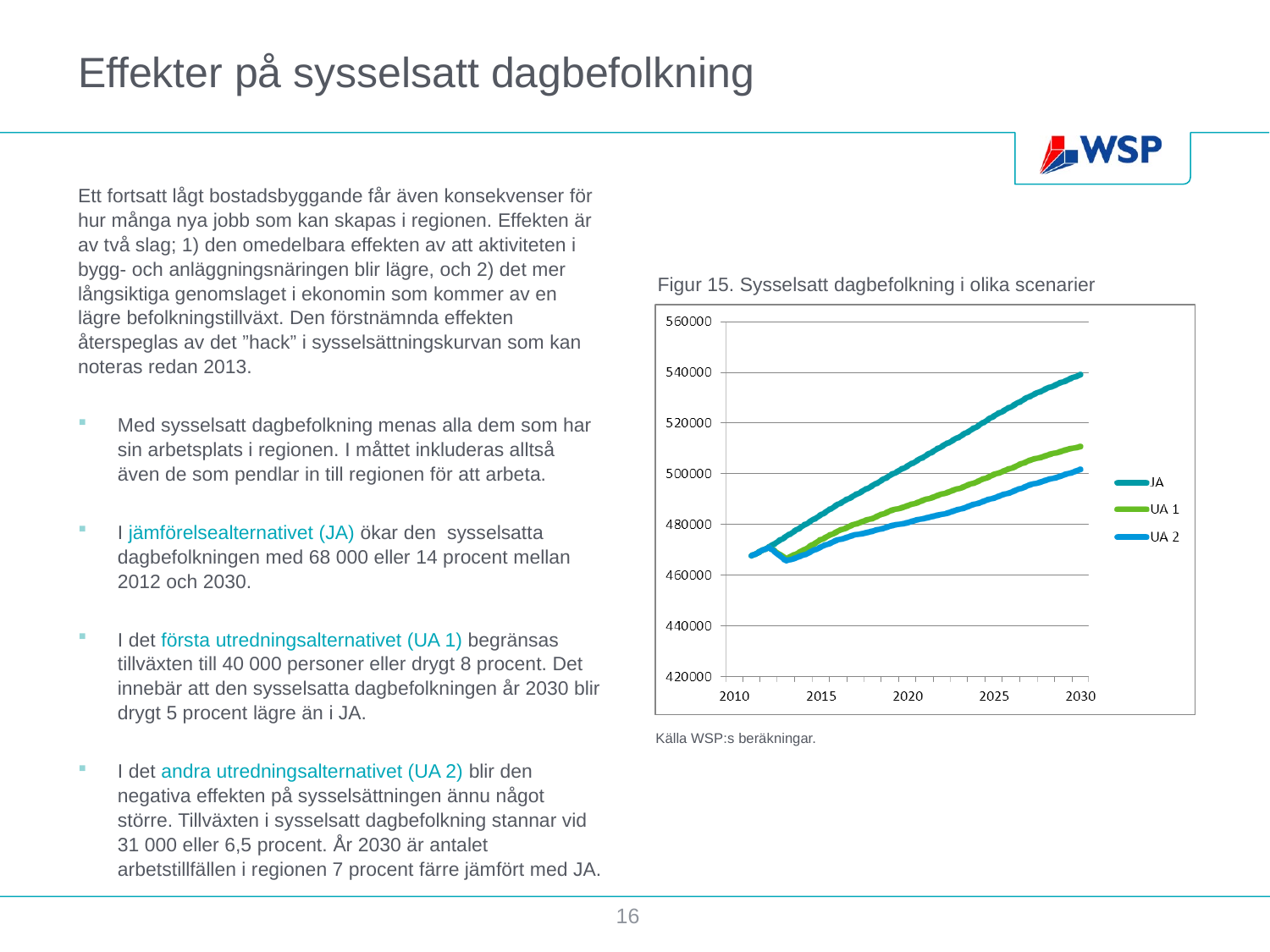
What is the title of the chart? Figur 15. Sysselsatt dagbefolkning i olika scenarier What kind of chart is shown in Figur 15? Line chart In 2030, which is larger, the value for UA 1 or the value for UA 2? UA 1 Does the JA series rise or fall between 2015 and 2030? Rise Which series has the highest value in 2030? JA Is the value for JA in 2011 greater or less than 480000? less What are the series names listed in the chart legend? JA, UA 1, UA 2 In 2030, which is larger, the value for JA or the value for UA 2? JA Which series has the lowest value in 2030? UA 2 Is the value for JA in 2030 greater or less than 520000? greater Is the value for UA 2 in 2030 greater or less than 520000? less How many series does the legend of the chart list? 3